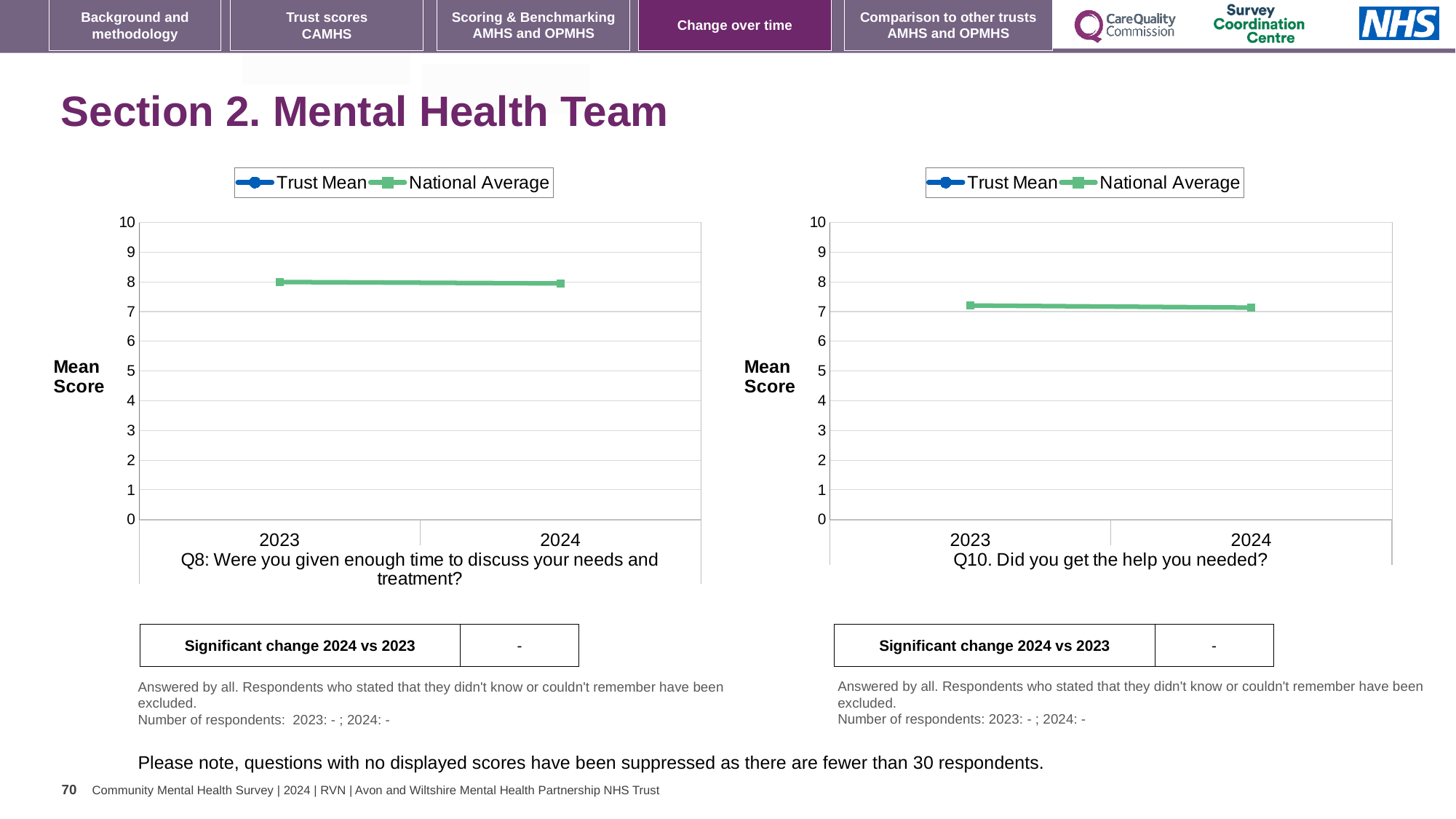
In the left chart (Q8), does the National Average line rise or fall from 2023 to 2024? fall In the right chart (Q10), is the National Average value for 2023 greater or less than 8? less What kind of chart is the right chart (Q10. Did you get the help you needed?)? line chart What is the label on the y axis of the left chart (Q8)? Mean Score In the left chart (Q8), is the National Average value for 2024 greater or less than 9? less How many years are shown on the x axis of the right chart (Q10)? 2 In the right chart (Q10), is the National Average value for 2024 greater or less than 6? greater How many series does the legend of the left chart (Q8) list? 2 Which series in the right chart (Q10) legend is shown in green? National Average What kind of chart is the left chart (Q8: Were you given enough time to discuss your needs and treatment?)? line chart What is the highest value shown on the y axis of the right chart (Q10)? 10